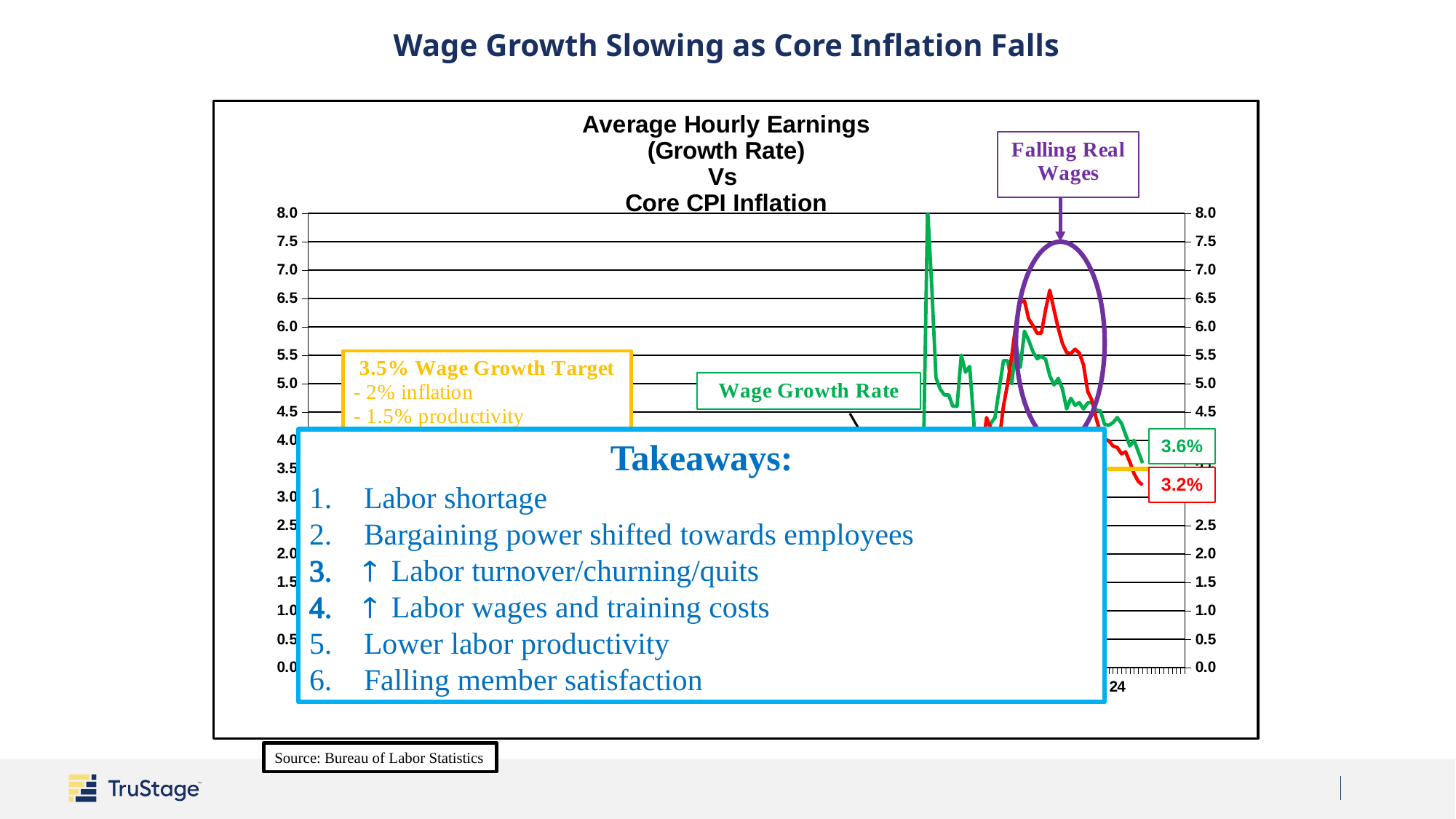
What does the purple annotation circling the peak region of the chart say? Falling Real Wages Is the peak of the Wage Growth Rate line greater or less than 7.0? greater What kind of chart is shown on the slide? Line chart What is the latest labeled value of the Core CPI Inflation line? 3.2% What is the maximum value shown on the vertical axis? 8.0 Which is larger at the end of the chart, the Wage Growth Rate (3.6%) or Core CPI Inflation (3.2%)? Wage Growth Rate What is the latest labeled value of the Wage Growth Rate line? 3.6% What wage growth target is marked on the chart? 3.5% Do the Wage Growth Rate and Core CPI Inflation lines rise or fall toward the right end of the chart? Fall Is the peak of the Core CPI Inflation line greater or less than 6.0? greater What is the difference between the latest Wage Growth Rate (3.6%) and the latest Core CPI Inflation (3.2%)? 0.4 percentage points